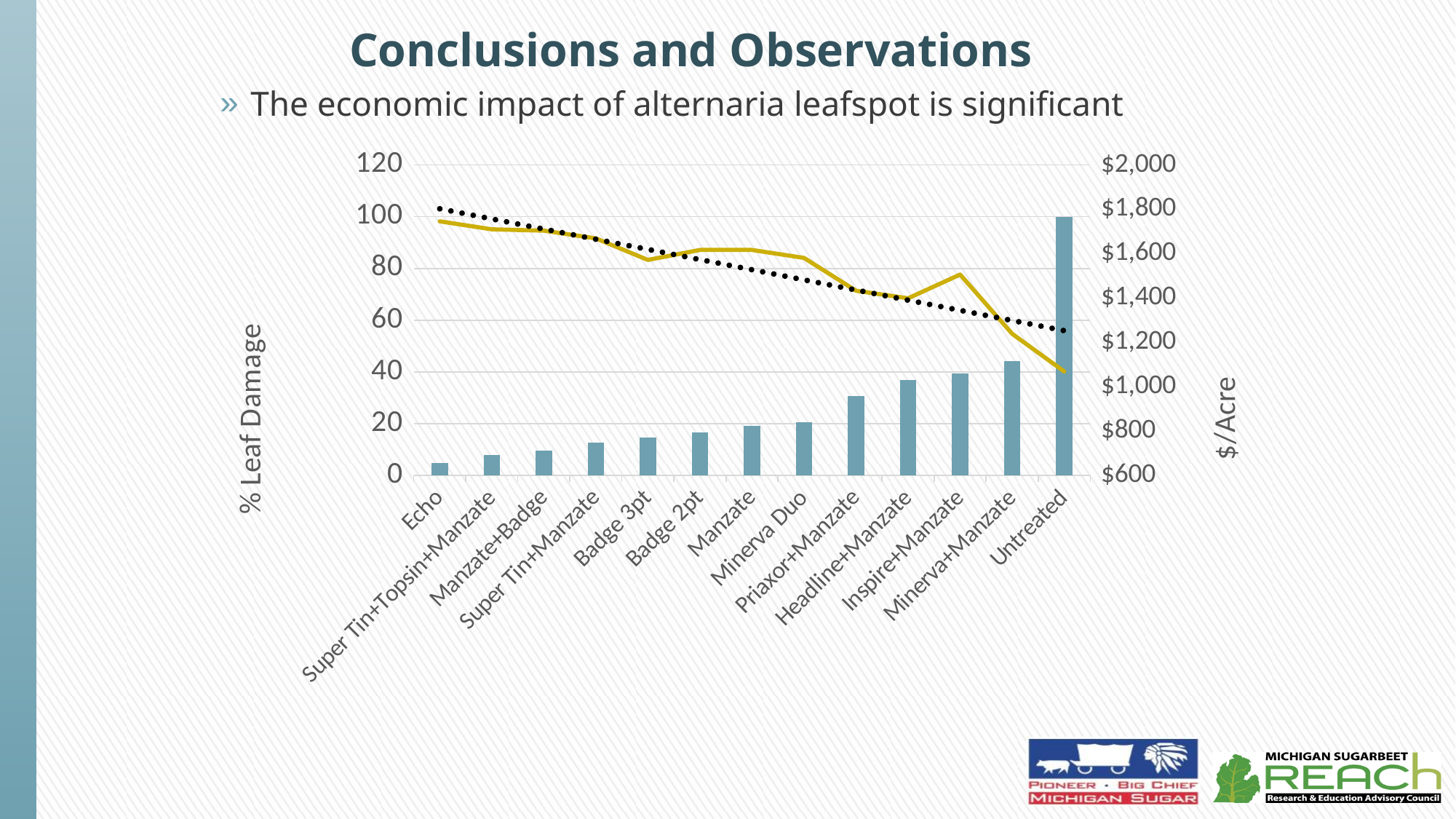
Is the % Leaf Damage bar for Minerva+Manzate greater or less than 60? less Is the % Leaf Damage bar for Priaxor+Manzate greater or less than 20? greater What is the title of the right-hand vertical axis? $/Acre Is the % Leaf Damage bar for Untreated greater or less than 80? greater Which category has the tallest bar for % Leaf Damage? Untreated How many treatment categories are shown along the x axis? 13 Which has a taller % Leaf Damage bar, Priaxor+Manzate or Badge 3pt? Priaxor+Manzate What kind of chart is shown on the slide? A combination bar and line chart Which category has the shortest bar for % Leaf Damage? Echo Do the % Leaf Damage bars generally rise or fall from Echo to Untreated along the x axis? rise